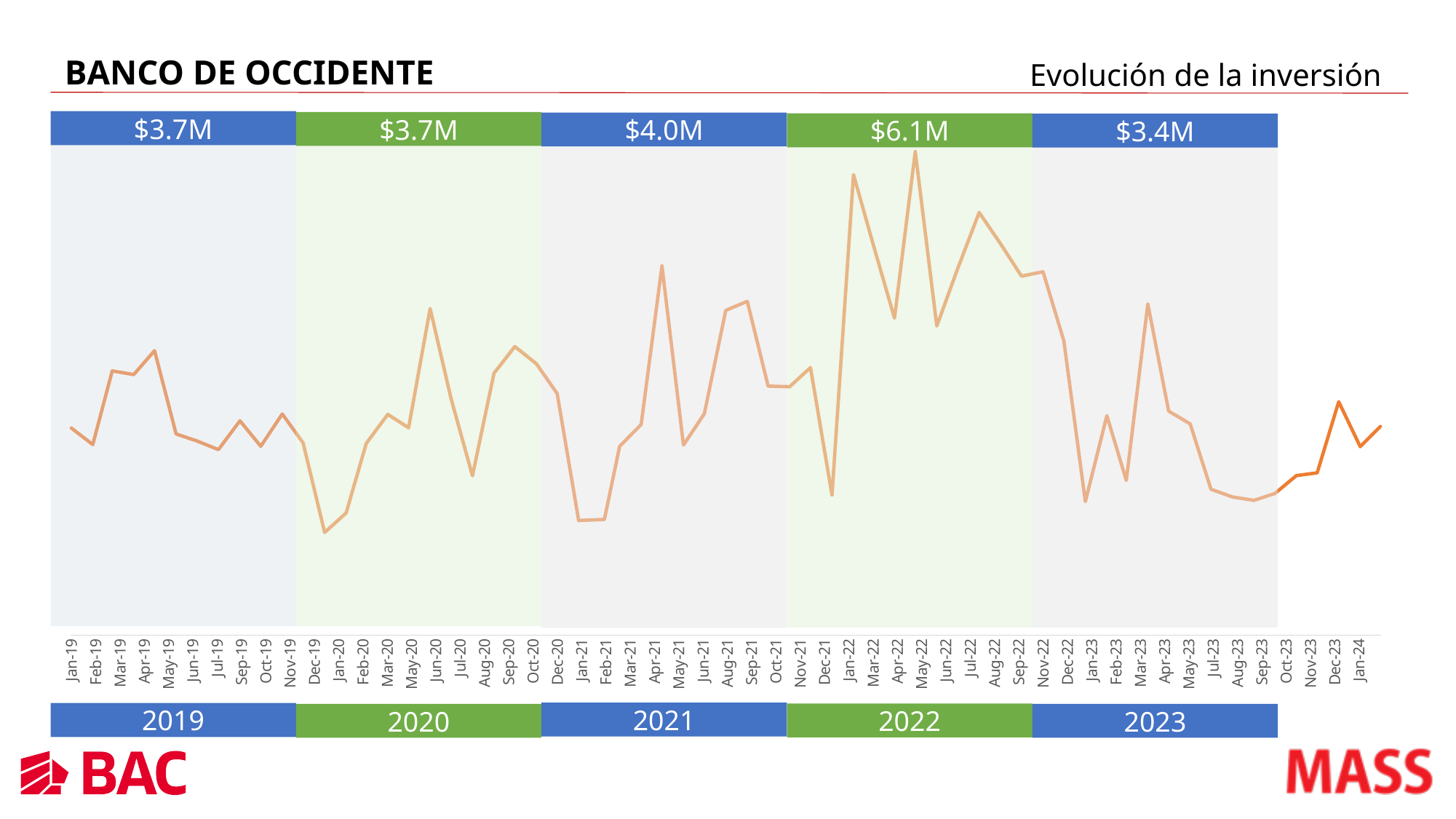
How many years have an annual total banner shown above the chart? 5 What is the annual investment total shown for 2023? $3.4M What kind of chart is shown on the slide? line chart In which month does the line reach its highest peak? May-22 Which year has the larger annual total, 2020 or 2021? 2021 What is the annual investment total shown for 2021? $4.0M Which year has the highest annual investment total? 2022 Does the line rise or fall from Mar-23 to Sep-23? fall What is the difference between the annual totals for 2022 and 2023? $2.7M Which year has the lowest annual investment total? 2023 What is the title shown at the top right of the slide? Evolución de la inversión What is the annual investment total shown for 2022? $6.1M